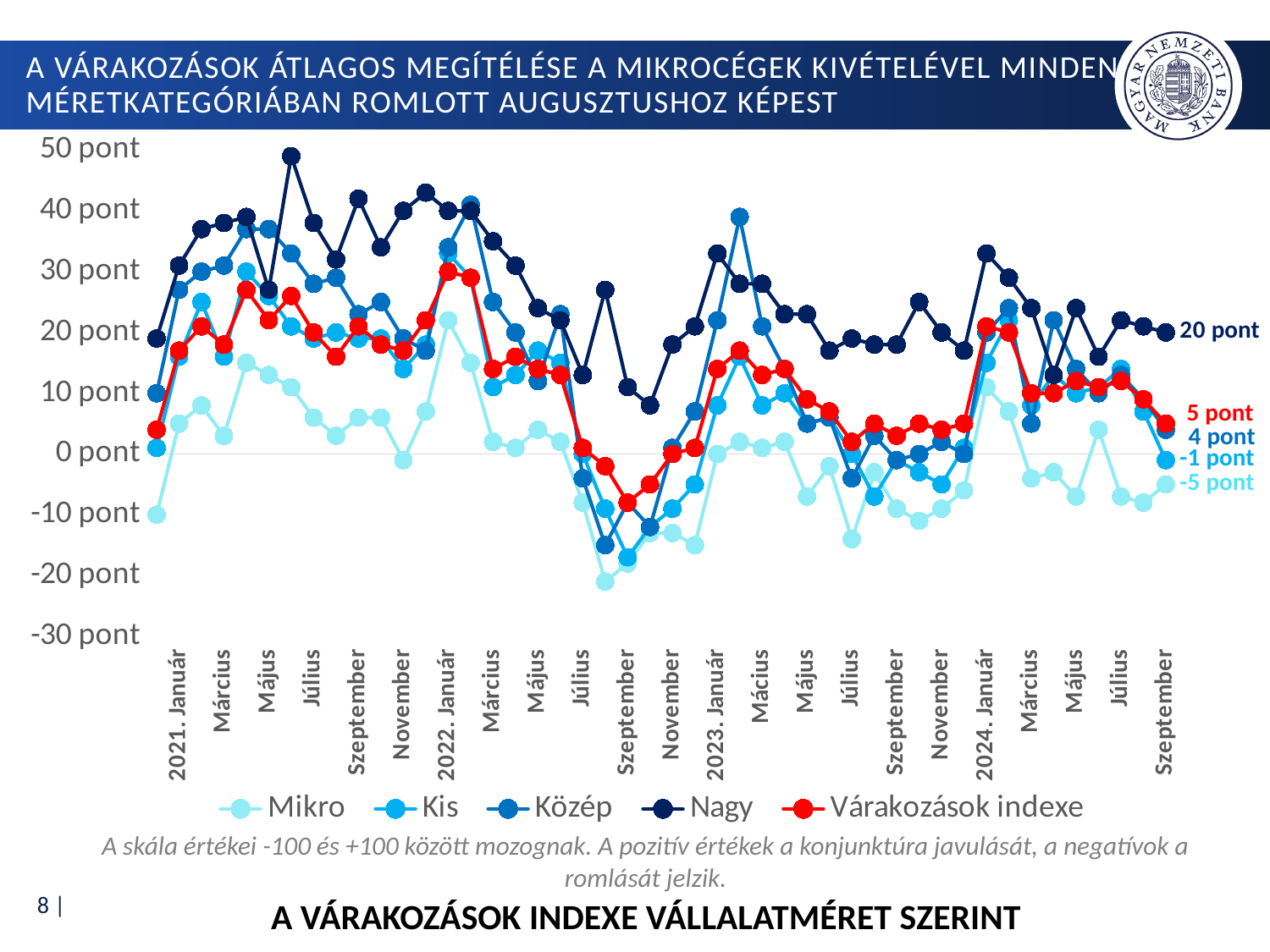
What kind of chart is shown on the slide? Line chart Is the value of the Mikro series at 2021 Január greater or less than 0 pont? greater At the last data point (2024 Szeptember), which is larger: the Közép value or the Kis value? Közép Which series has the lowest value at the last data point (2024 Szeptember)? Mikro Does the Nagy series rise or fall between 2024 Január and 2024 Szeptember? Fall What is the value of the Mikro series at the last data point (2024 Szeptember)? -5 pont Which series has the highest value at the last data point (2024 Szeptember)? Nagy What is the value of the Kis series at the last data point (2024 Szeptember)? -1 pont What is the value of the Várakozások indexe series at the last data point (2024 Szeptember)? 5 pont How many series does the legend list? 5 What is the difference between the Nagy and Várakozások indexe values at the last data point (2024 Szeptember)? 15 pont What is the value of the Nagy series at the last data point (2024 Szeptember)? 20 pont